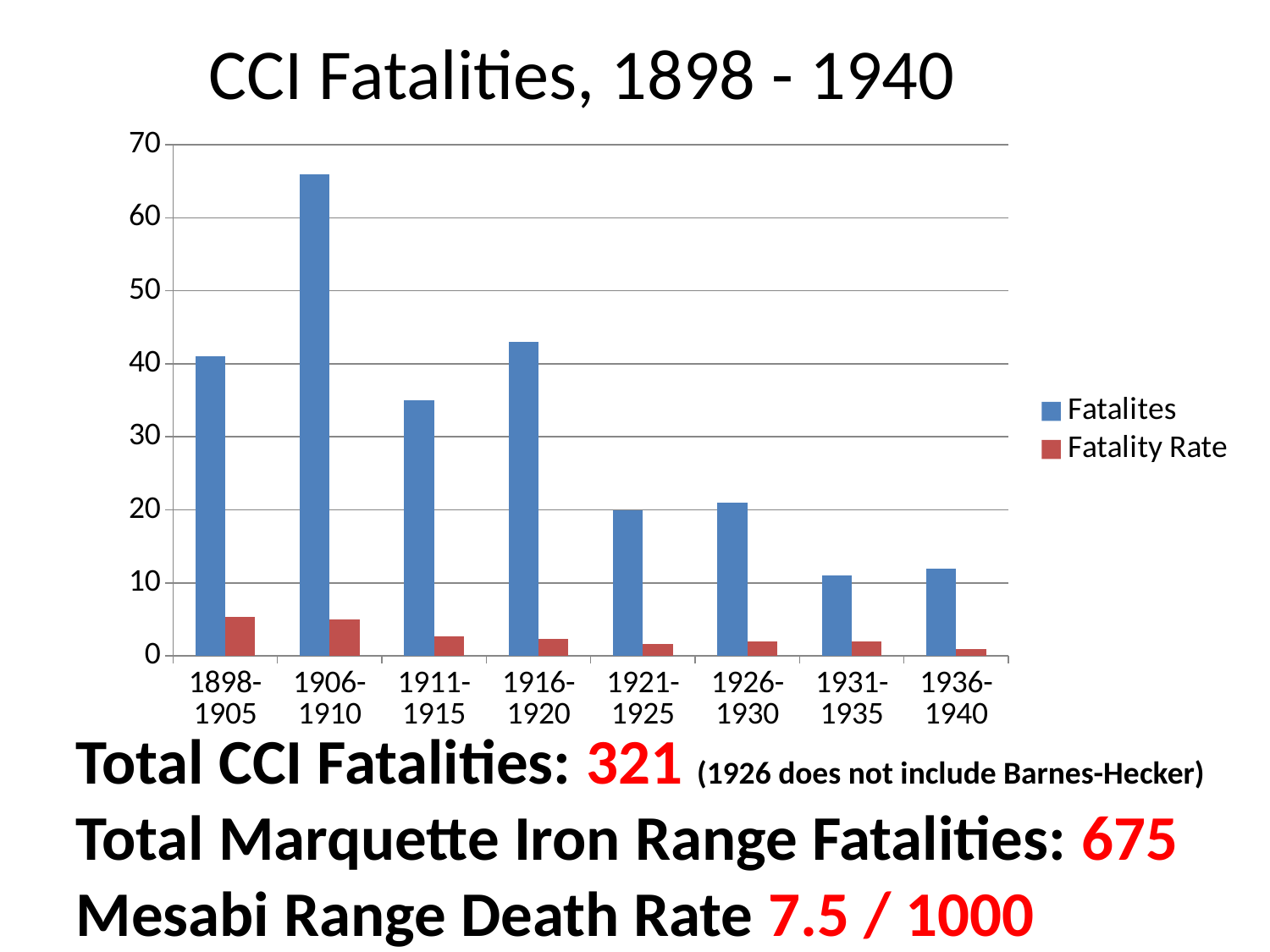
Which period has the lowest Fatality Rate? 1936-1940 Is the Fatalites value for 1911-1915 greater or less than 40? less How many time periods are shown on the x axis? 8 Is the Fatalites value for 1906-1910 greater or less than 60? greater Which period has more Fatalites, 1916-1920 or 1921-1925? 1916-1920 Which period has more Fatalites, 1898-1905 or 1911-1915? 1898-1905 What is the title of the chart? CCI Fatalities, 1898 - 1940 How many series does the legend list? 2 Which period has the highest number of Fatalites? 1906-1910 Is the Fatalites value for 1921-1925 greater or less than 30? less Overall, do the Fatalites values rise or fall from 1906-1910 to 1936-1940? fall What kind of chart is shown on the slide? bar chart